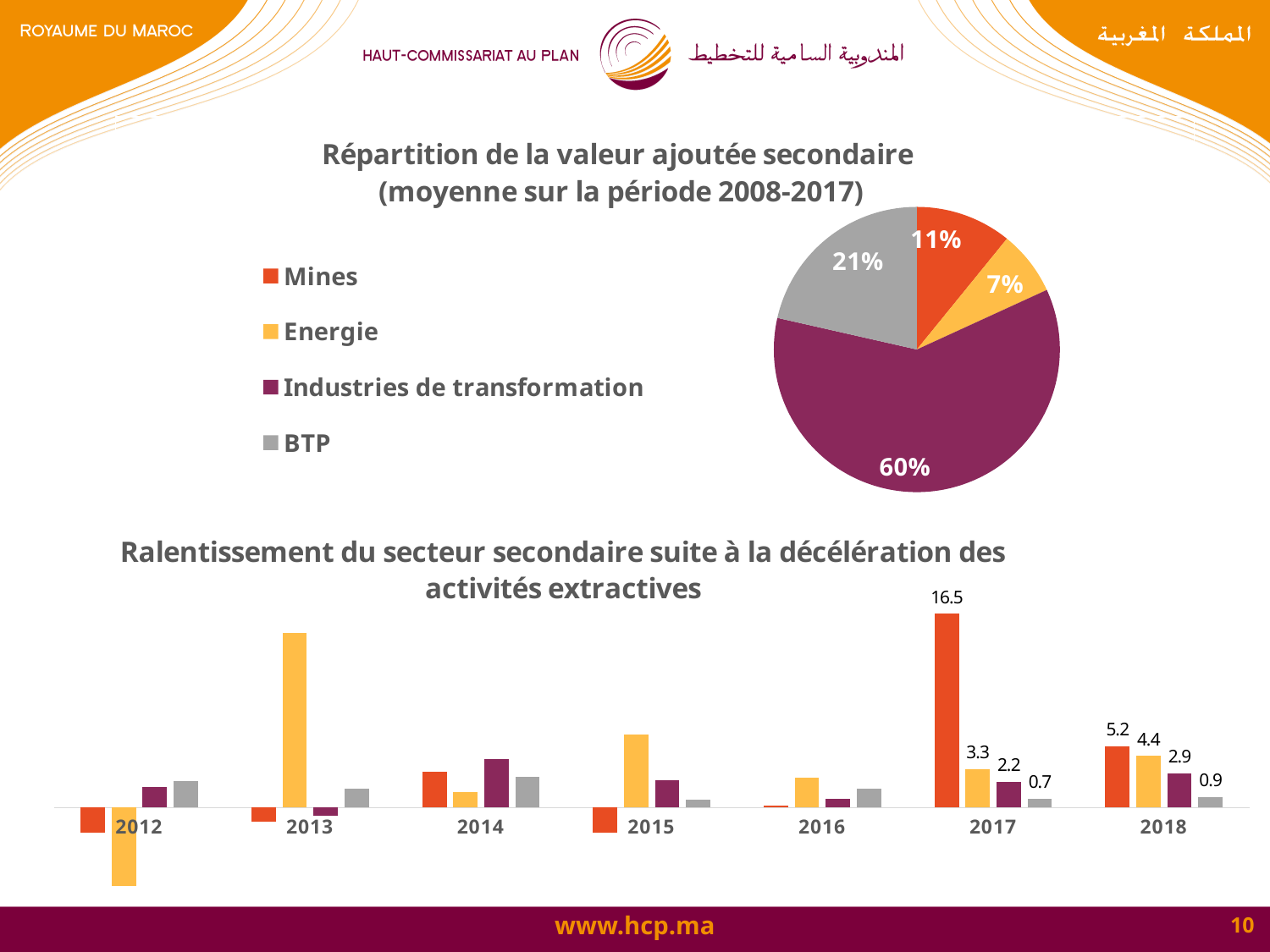
In the bar chart at the bottom of the slide, what is the value of the orange bar for 2017? 16.5 In the pie chart 'Répartition de la valeur ajoutée secondaire', what share does Industries de transformation hold? 60% How many categories does the legend of the pie chart 'Répartition de la valeur ajoutée secondaire' list? 4 In the pie chart 'Répartition de la valeur ajoutée secondaire', what share does Energie hold? 7% How many years are shown on the x axis of the bar chart at the bottom of the slide? 7 In the pie chart 'Répartition de la valeur ajoutée secondaire', which category has the largest share? Industries de transformation In the pie chart 'Répartition de la valeur ajoutée secondaire', how many percentage points larger is the Mines share than the Energie share? 4 What kind of chart is the chart at the top of the slide? Pie chart In the pie chart 'Répartition de la valeur ajoutée secondaire', what share does BTP hold? 21% In the pie chart 'Répartition de la valeur ajoutée secondaire', which category has the smallest share? Energie In the bar chart at the bottom of the slide, what is the value of the grey bar for 2018? 0.9 What kind of chart is the chart at the bottom of the slide? Bar chart